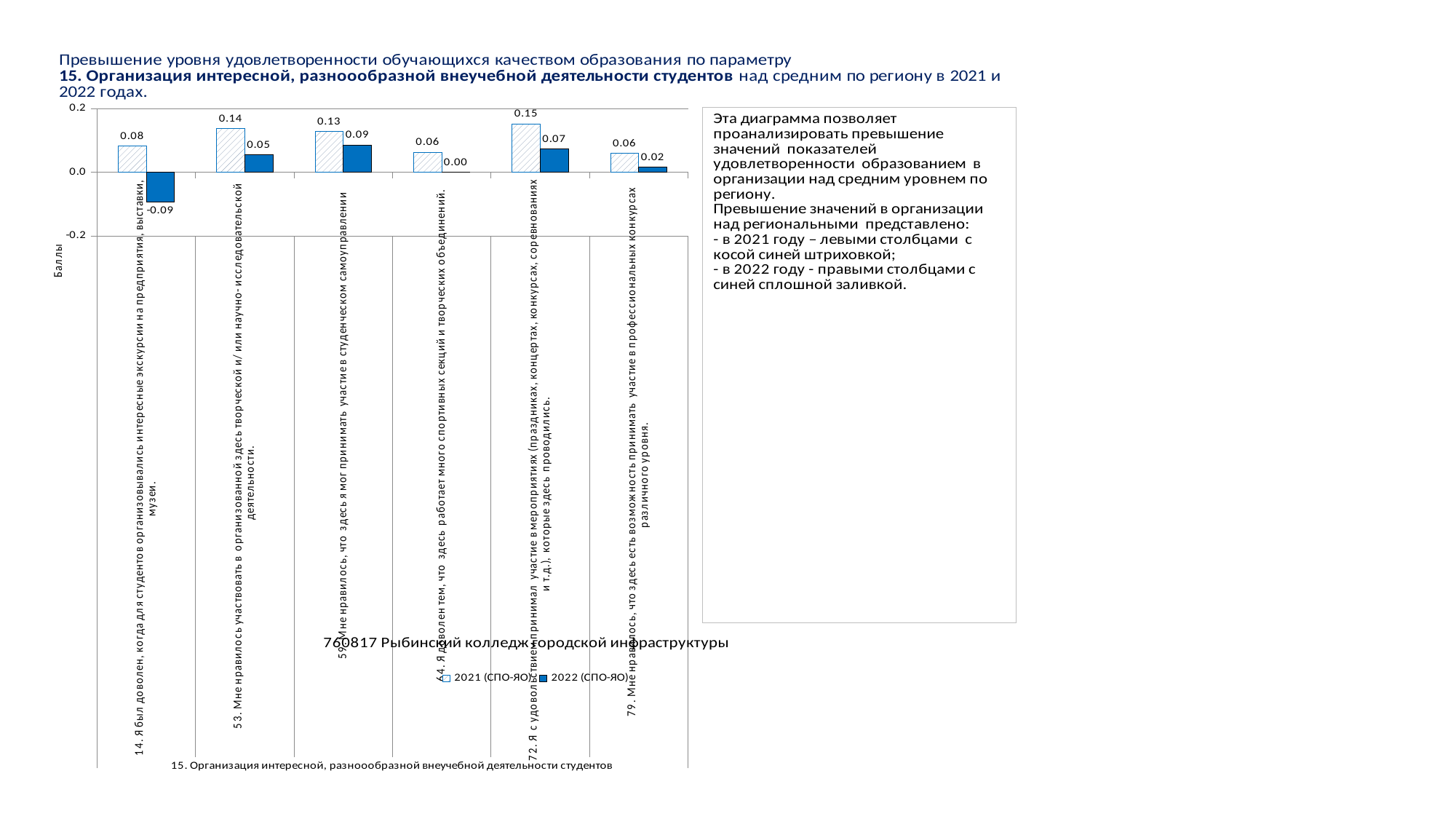
What is the 2022 (СПО-ЯО) value for item 59 ("Мне нравилось, что здесь я мог принимать участие в студенческом самоуправлении")? 0.09 What is the 2021 (СПО-ЯО) value for item 14 ("Я был доволен, когда для студентов организовывались интересные экскурсии...")? 0.08 Which item has the highest 2021 (СПО-ЯО) value? 72. Я с удовольствием принимал участие в мероприятиях (праздниках, концертах, конкурсах, соревнованиях и т.д.), которые здесь проводились. What is the 2021 (СПО-ЯО) value for item 72 ("Я с удовольствием принимал участие в мероприятиях...")? 0.15 What type of chart is shown on the slide? Bar chart How many series does the chart legend list? 2 Which item has the lowest 2022 (СПО-ЯО) value? 14. Я был доволен, когда для студентов организовывались интересные экскурсии на предприятия, выставки, музеи. How many items (categories) are shown on the x axis of the chart? 6 What is the difference between the 2021 (СПО-ЯО) and 2022 (СПО-ЯО) values for item 53 ("Мне нравилось участвовать в организованной здесь творческой и/или научно-исследовательской деятельности")? 0.09 What is the label of the vertical axis of the chart? Баллы For item 79 ("Мне нравилось, что здесь есть возможность принимать участие в профессиональных конкурсах различного уровня"), which series has the larger value, 2021 (СПО-ЯО) or 2022 (СПО-ЯО)? 2021 (СПО-ЯО) What is the 2022 (СПО-ЯО) value for item 14 ("Я был доволен, когда для студентов организовывались интересные экскурсии...")? -0.09